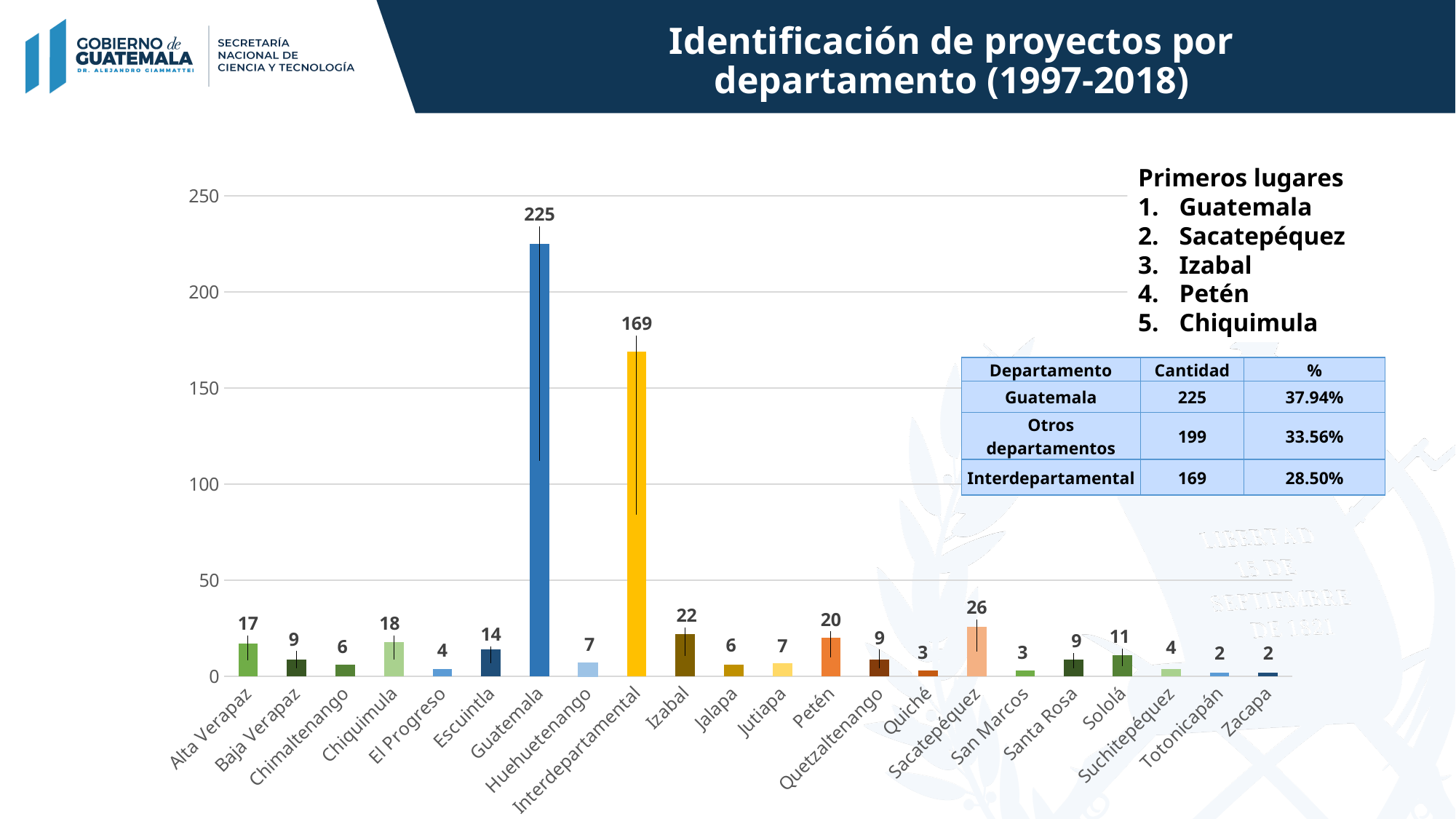
What is the difference between the values for Sacatepéquez and Izabal? 4 Which is larger, the value for Escuintla or the value for Sololá? Escuintla What is the title of the slide? Identificación de proyectos por departamento (1997-2018) How many categories are shown on the x axis? 22 What kind of chart is shown on the slide? Bar chart What is the value for Sacatepéquez? 26 What is the value for Interdepartamental? 169 What is the value for Chiquimula? 18 What is the difference between the values for Guatemala and Interdepartamental? 56 What is the value for Petén? 20 What is the value for Guatemala? 225 Which category has the highest value? Guatemala